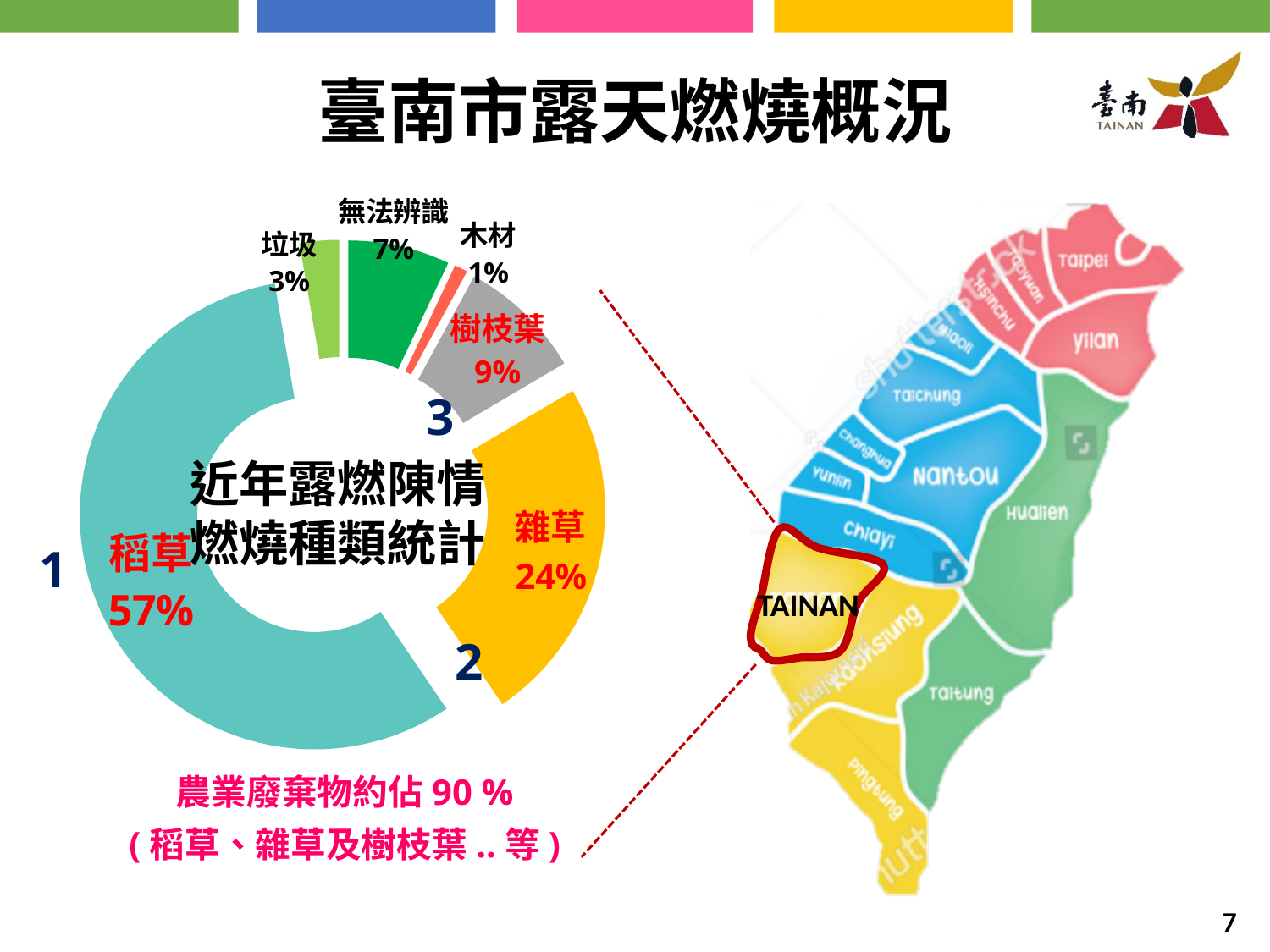
What kind of chart is shown on the slide? Donut (pie) chart Which category has the smallest share in the chart? 木材 What percentage is shown for 垃圾? 3% How many percentage points larger is 稻草 than 雜草? 33 What is the title printed in the centre of the chart? 近年露燃陳情燃燒種類統計 How many categories are shown in the chart? 6 What share of the donut chart does 稻草 account for? 57% Which is larger, the share for 樹枝葉 or the share for 無法辨識? 樹枝葉 What percentage is shown for 無法辨識? 7% What percentage is shown for 樹枝葉? 9% What percentage is shown for 雜草 in the chart? 24% Which category has the largest share in the chart? 稻草